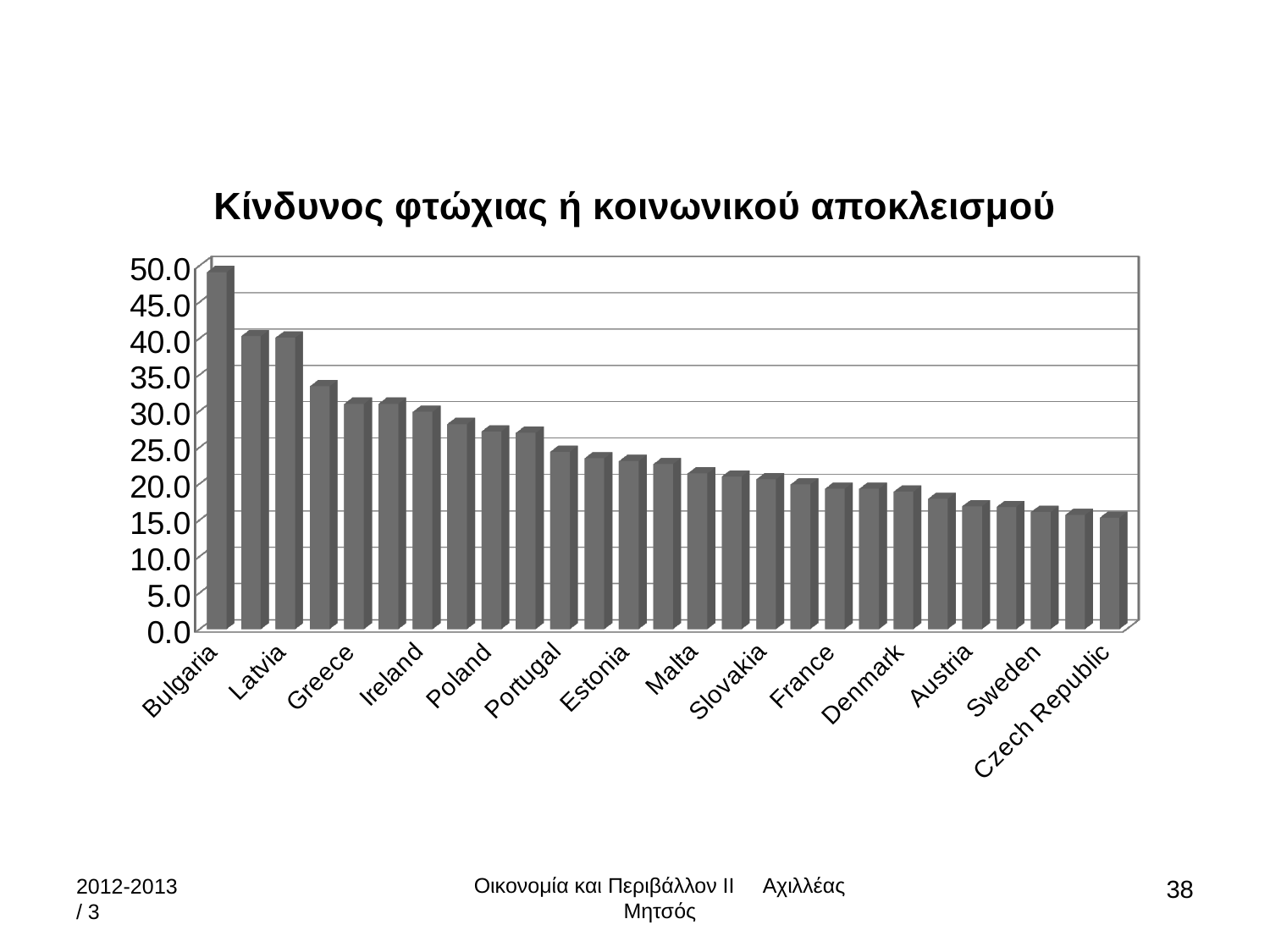
Which country has the highest value in the chart? Bulgaria Is the value for Bulgaria greater or less than 45.0? greater Is the value for Poland greater or less than 25.0? greater Is the value for Denmark greater or less than 20.0? less How many bars are plotted in the chart? 27 What kind of chart is shown on the slide? bar chart Which has the larger value, Bulgaria or Greece? Bulgaria What is the title of the chart? Κίνδυνος φτώχιας ή κοινωνικού αποκλεισμού Do the values rise or fall from left to right along the x axis? fall